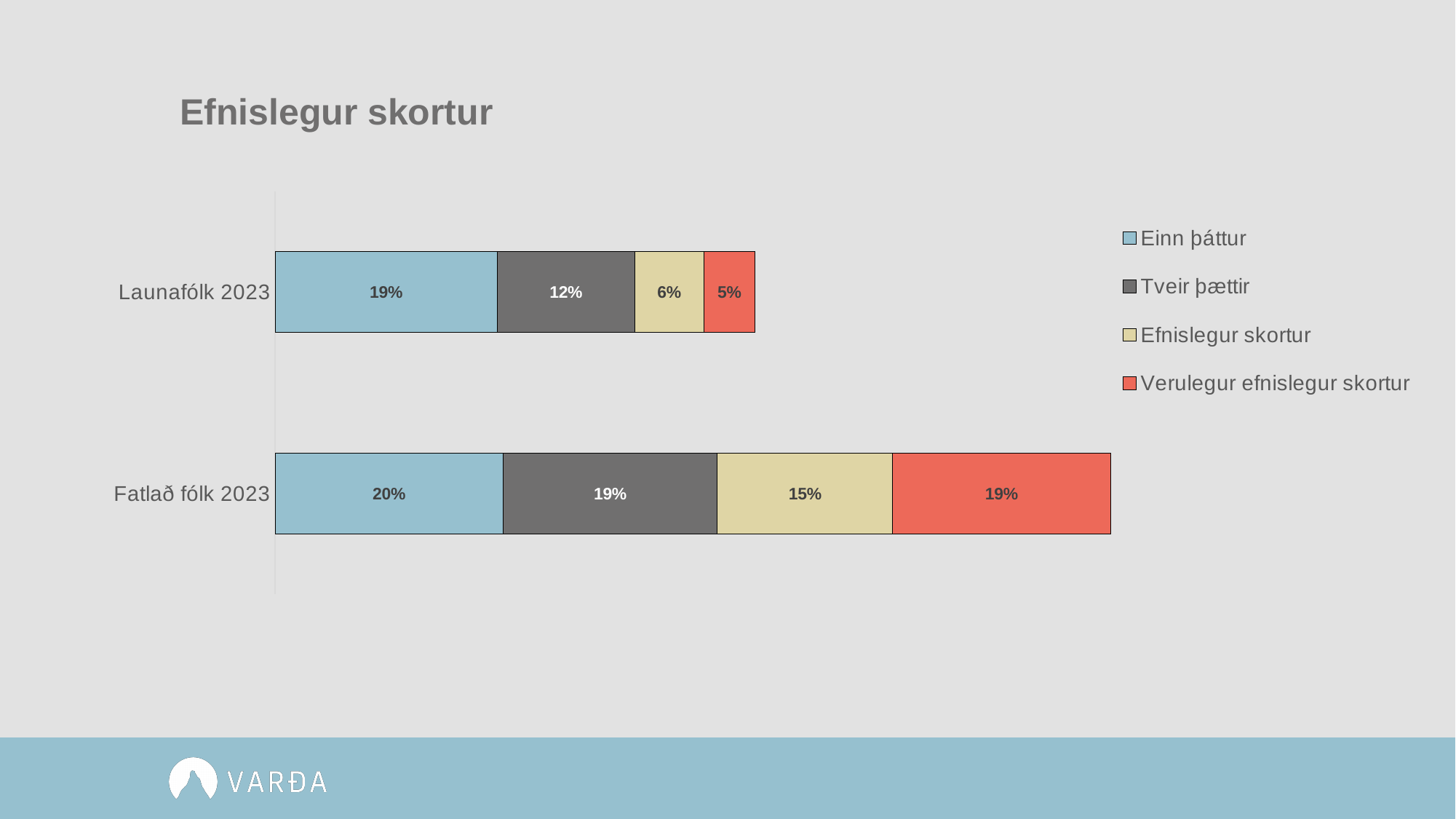
Which category has the higher value for "Verulegur efnislegur skortur", Launafólk 2023 or Fatlað fólk 2023? Fatlað fólk 2023 What is the title of the chart? Efnislegur skortur How many categories are shown on the chart? 2 What is the value of "Efnislegur skortur" for Launafólk 2023? 6% What is the value of "Verulegur efnislegur skortur" for Fatlað fólk 2023? 19% What is the total of the stacked bar for Fatlað fólk 2023? 73% How many series does the legend list? 4 What is the difference between the "Efnislegur skortur" values for Fatlað fólk 2023 and Launafólk 2023? 9% What is the value of "Tveir þættir" for Fatlað fólk 2023? 19% What is the total of the stacked bar for Launafólk 2023? 42% What kind of chart is shown on the slide? Stacked bar chart What is the value of "Einn þáttur" for Launafólk 2023? 19%